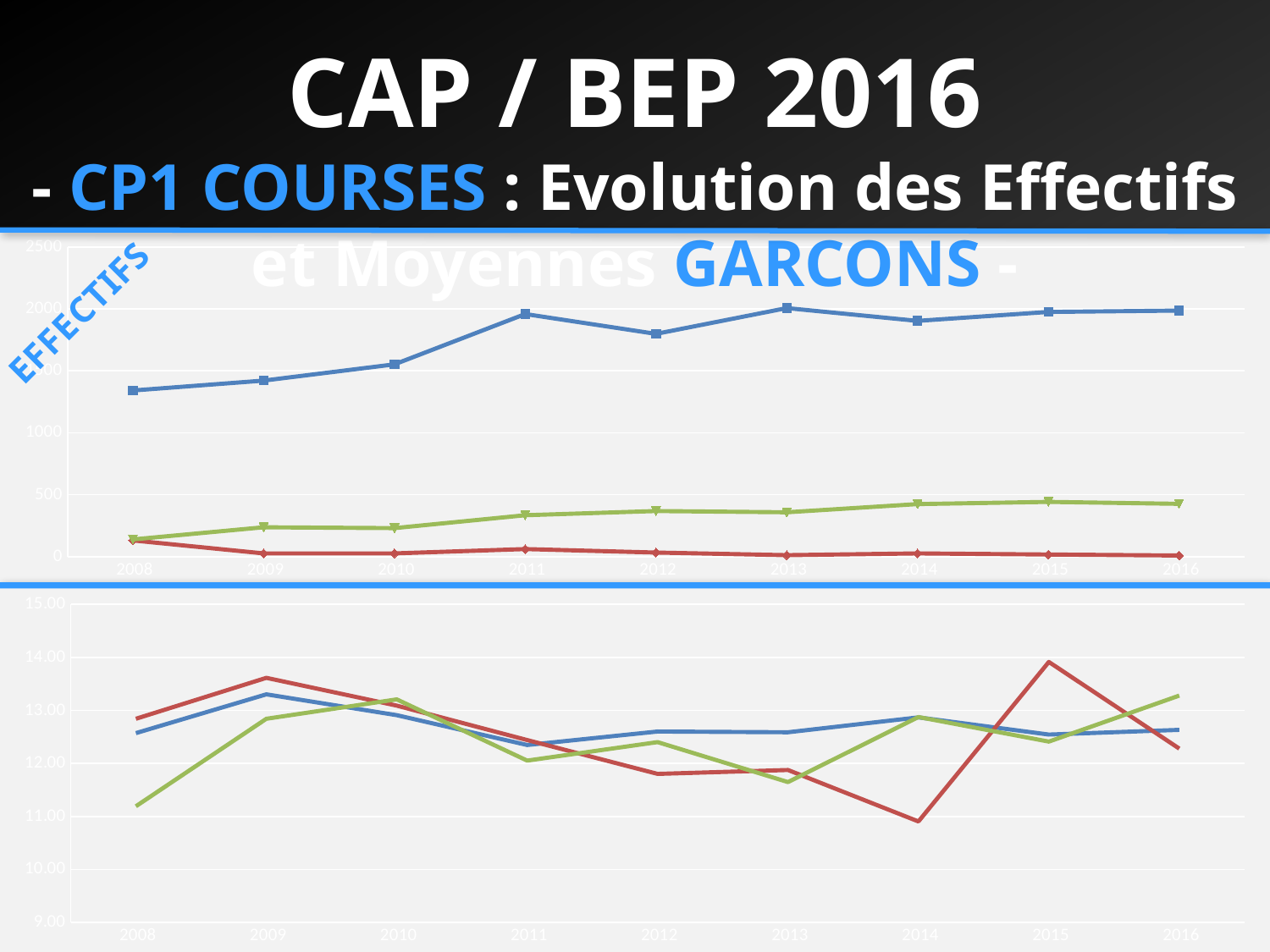
In the bottom chart, is the value of the red line in 2015 greater or less than 13.00? greater In the bottom chart, is the value of the red line in 2014 greater or less than 12.00? less In the top chart (EFFECTIFS), does the green line rise or fall from 2008 to 2016? rises In the bottom chart, which line is higher in 2008, the blue line or the green line? blue In the top chart (EFFECTIFS), is the value of the blue line in 2008 greater or less than 1500? less In the top chart (EFFECTIFS), in which year is the blue line at its lowest? 2008 In the bottom chart, in which year is the red line at its lowest? 2014 How many years are shown on the x axis of the top chart (EFFECTIFS)? 9 In the top chart (EFFECTIFS), does the red line rise or fall from 2008 to 2016? falls In the top chart (EFFECTIFS), which coloured line has the highest values across all years? blue What kind of chart is the top chart (EFFECTIFS)? line chart